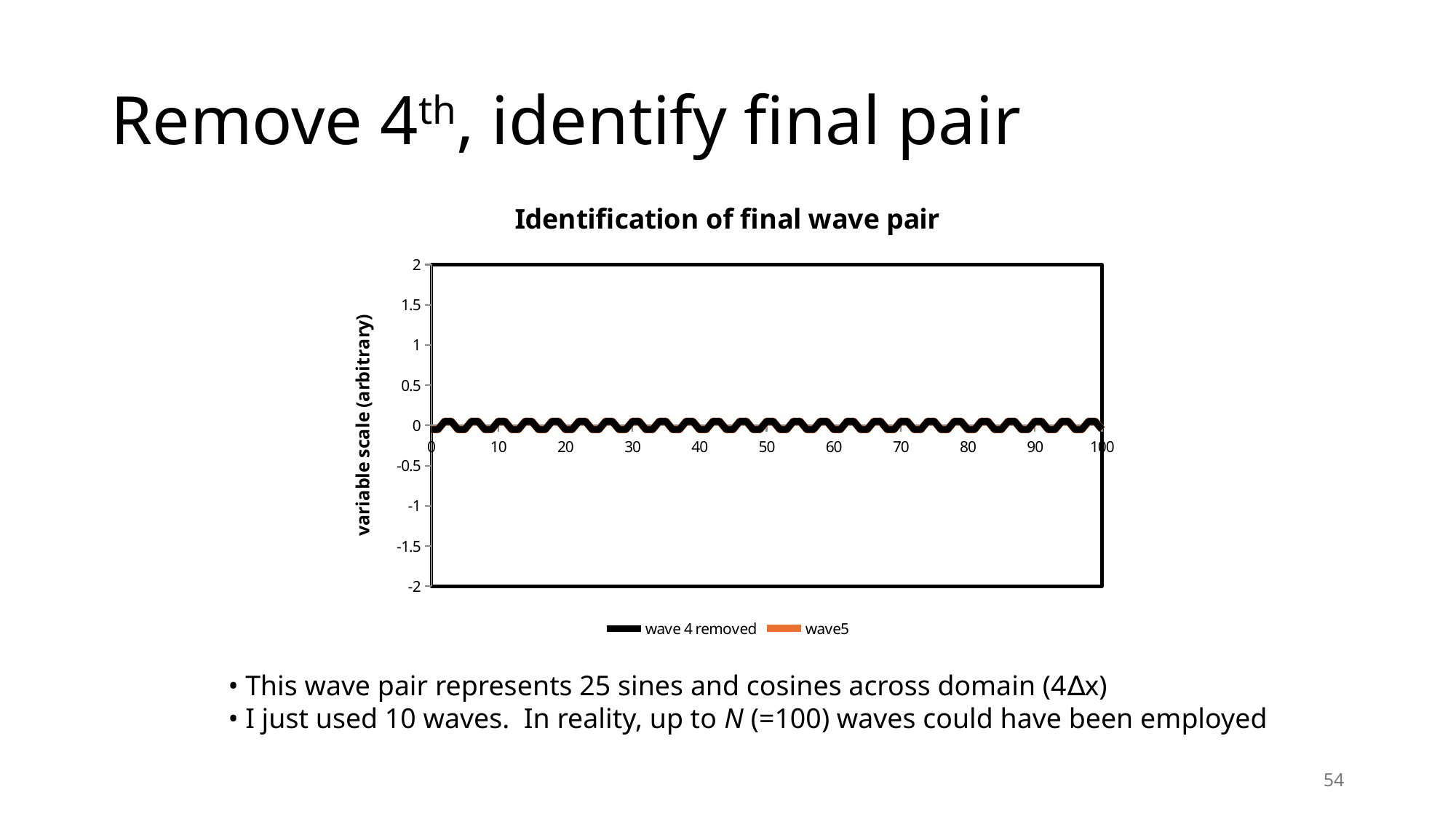
Is the value of the 'wave 4 removed' series at x = 50 greater or less than -1? greater What kind of chart is shown on the slide? line chart Is the value of the 'wave5' series at x = 20 greater or less than 0.5? less Is the value of the 'wave 4 removed' series at x = 50 greater or less than 1? less How many series does the legend list? 2 What is the title of the chart? Identification of final wave pair What colour is the 'wave5' series in the legend? orange